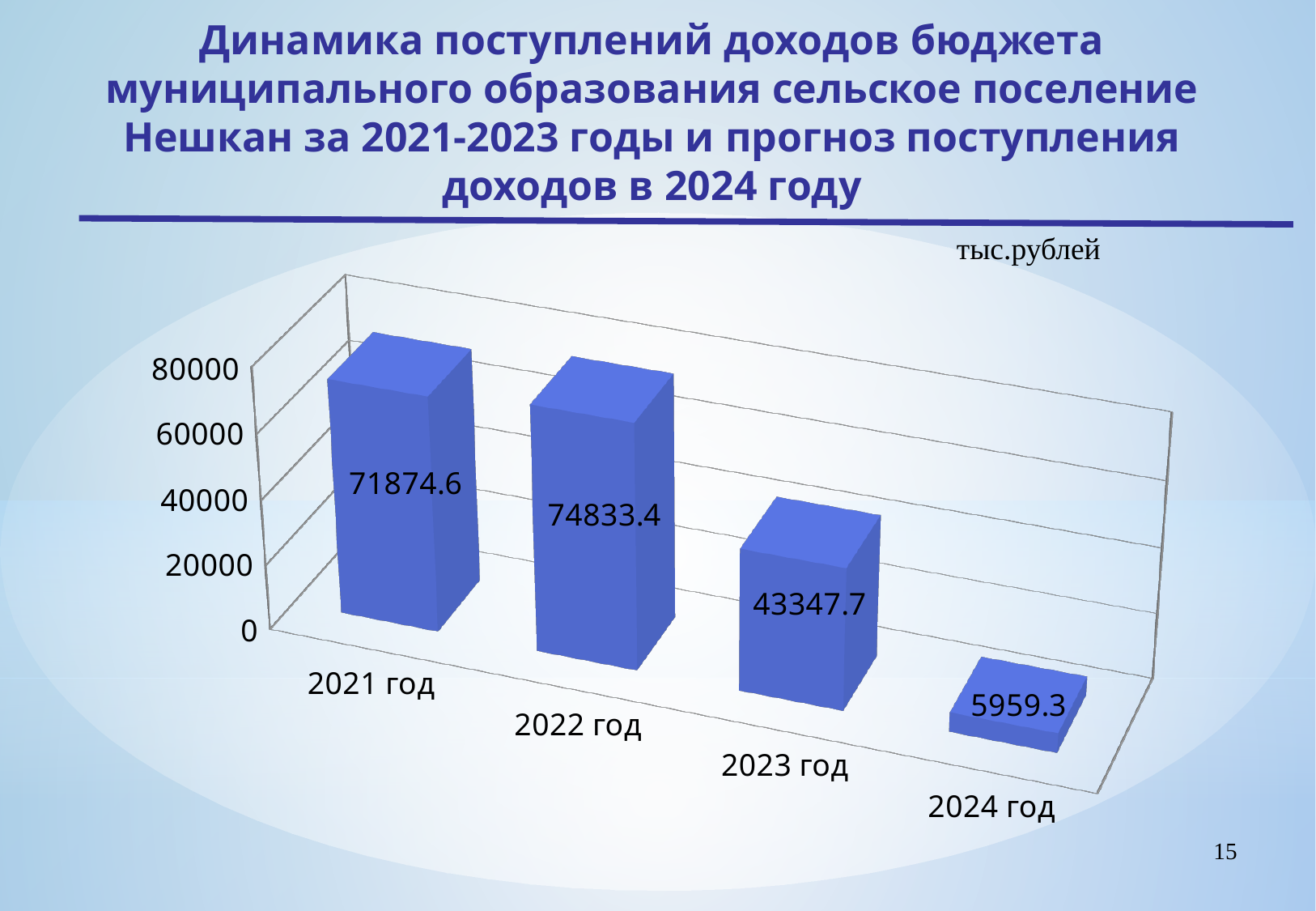
Which year has the highest value? 2022 год What is the value for 2022 год? 74833.4 What is the difference between the values for 2023 год and 2024 год? 37388.4 What is the difference between the values for 2022 год and 2021 год? 2958.8 What is the value for 2023 год? 43347.7 What is the value for 2021 год? 71874.6 Which year has the lowest value? 2024 год What kind of chart is shown on the slide? Bar chart Do the values rise or fall from 2022 год to 2024 год? Fall How many years are shown on the chart? 4 Which is larger, the value for 2021 год or the value for 2023 год? 2021 год What is the forecast value for 2024 год? 5959.3